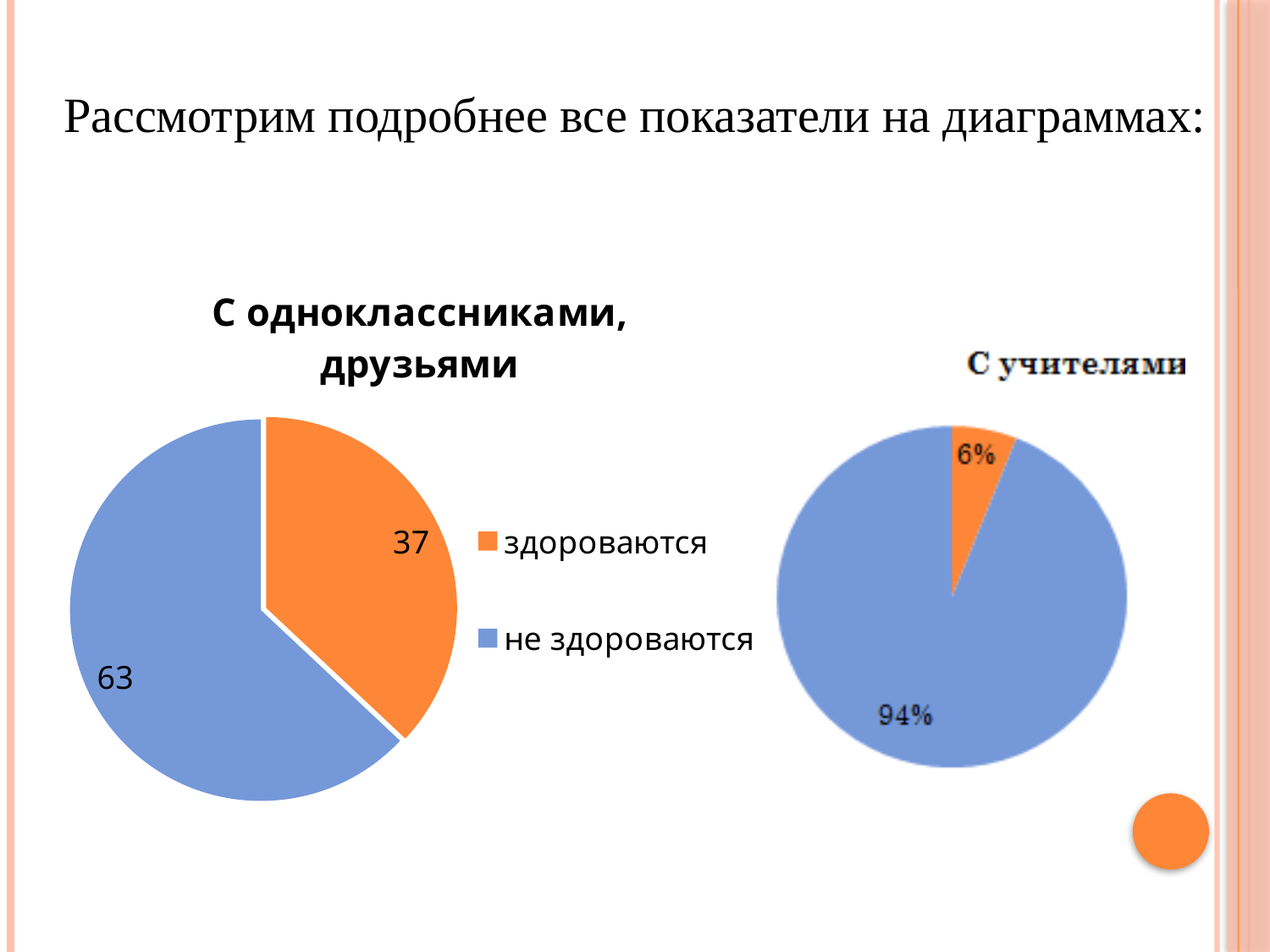
In the chart titled "С одноклассниками, друзьями", what is the value for "не здороваются"? 63 In the chart titled "С одноклассниками, друзьями", which category has the largest slice? не здороваются In the chart titled "С одноклассниками, друзьями", what is the difference between the values for "не здороваются" and "здороваются"? 26 How many entries does the legend on the slide list? 2 How many slices does the chart titled "С одноклассниками, друзьями" have? 2 In the chart titled "С учителями", which category has the smallest slice? здороваются In the chart titled "С учителями", which is larger: "здороваются" or "не здороваются"? не здороваются In the chart titled "С одноклассниками, друзьями", what is the value for "здороваются"? 37 What kind of chart is the chart titled "С учителями"? pie chart What colour represents "здороваются" in the charts? orange In the chart titled "С учителями", what is the value for "не здороваются"? 94% In the chart titled "С учителями", what is the value for "здороваются"? 6%